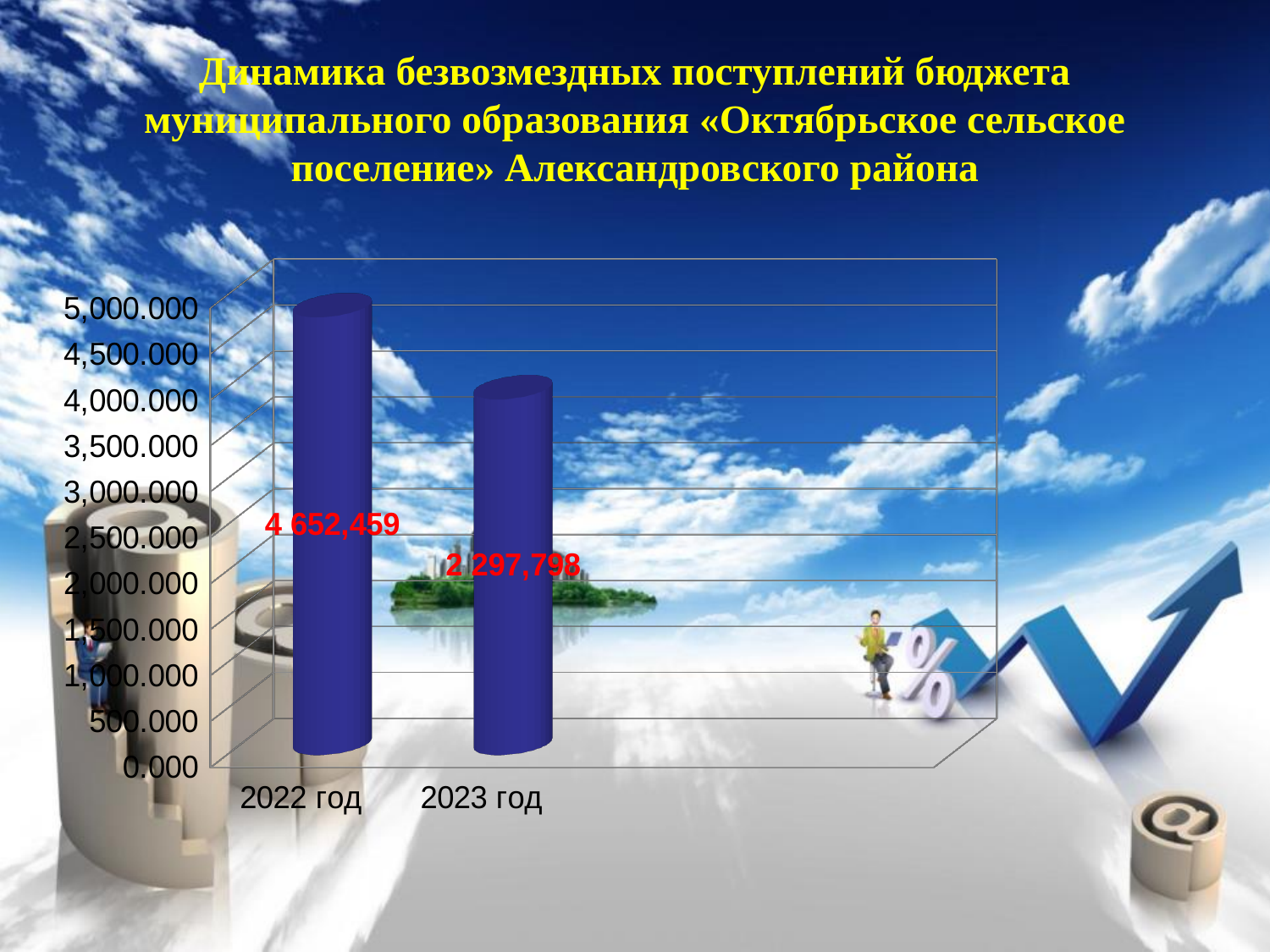
What is the value for 2023 год? 2 297,798 What is the highest value shown on the vertical axis? 5,000.000 What is the value for 2022 год? 4 652,459 Which is larger, the value for 2022 год or the value for 2023 год? 2022 год How many categories are shown on the x axis? 2 Is the value for 2022 год greater or less than 4,000.000? greater What is the difference between the values for 2022 год and 2023 год? 2 354,661 Which year has the highest value? 2022 год Do the values rise or fall from 2022 год to 2023 год? fall Which year has the lowest value? 2023 год What kind of chart is shown on the slide? bar chart